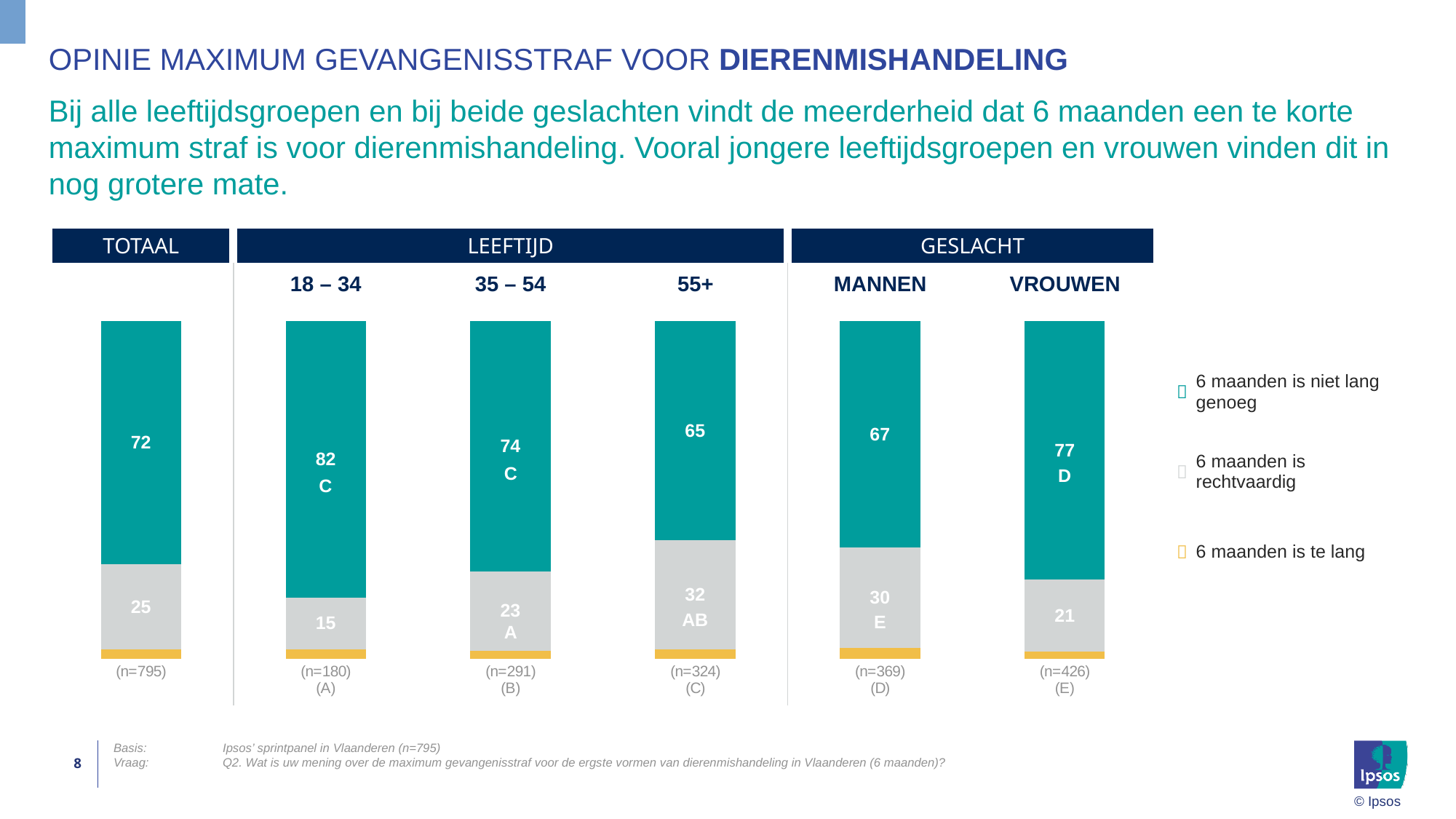
How many bars (groups) are shown in the chart? 6 Which group has the highest value for "6 maanden is niet lang genoeg"? 18 – 34 What kind of chart is shown on the slide? Stacked bar chart What is the value for "6 maanden is rechtvaardig" in the 55+ age group? 32 What percentage of the total sample (TOTAAL) says 6 months is not long enough ("6 maanden is niet lang genoeg")? 72 What is the value for "6 maanden is niet lang genoeg" among VROUWEN? 77 What is the sample size (n) shown under the VROUWEN bar? (n=426) Which is larger for "6 maanden is rechtvaardig": the 35 – 54 group or the 55+ group? 55+ Which group has the lowest value for "6 maanden is niet lang genoeg"? 55+ How many series does the legend list? 3 What is the difference between MANNEN and VROUWEN for "6 maanden is niet lang genoeg"? 10 What is the value for "6 maanden is rechtvaardig" in the 18 – 34 age group? 15